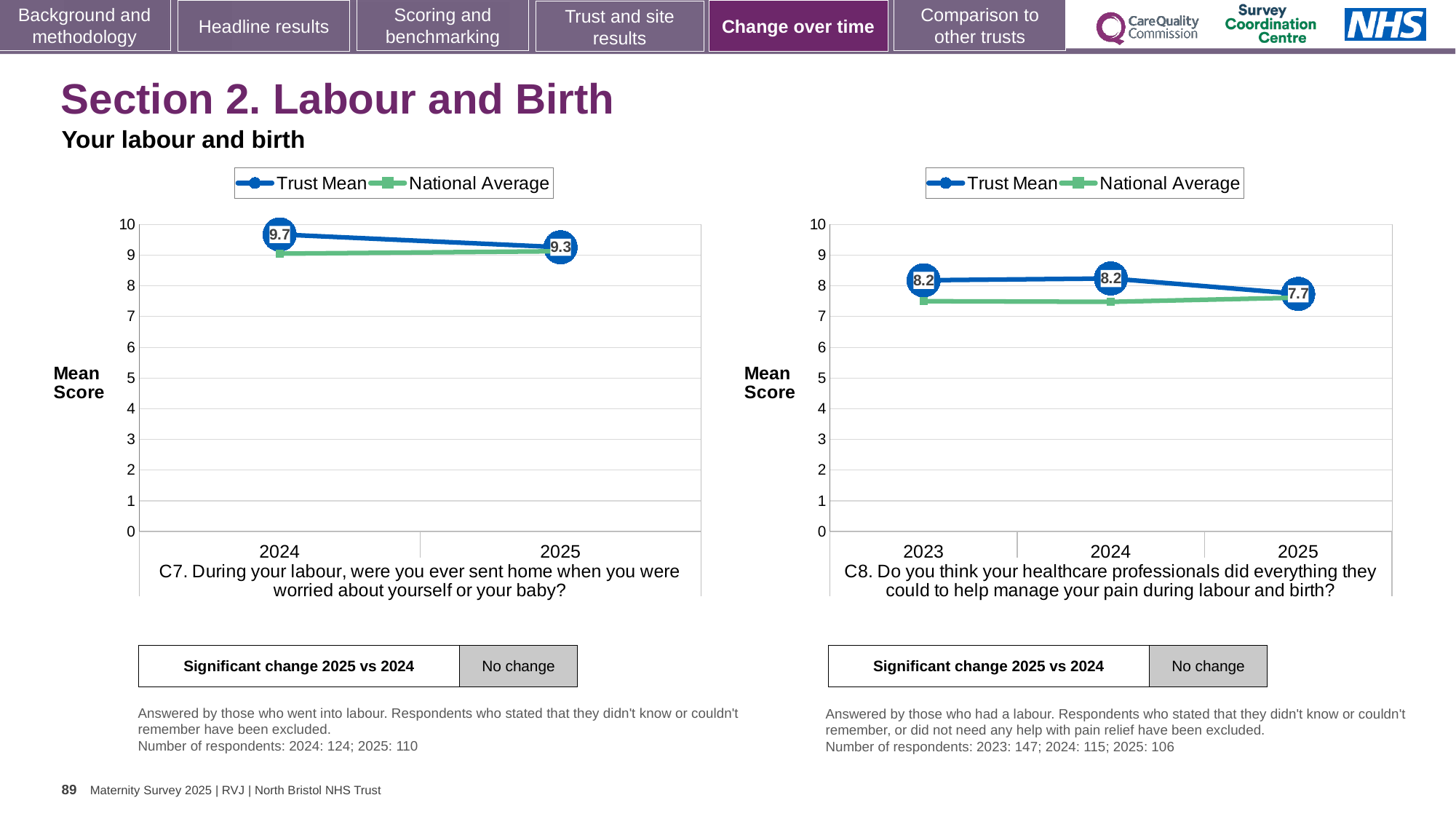
In the C7 chart on the left, by how much did the Trust Mean fall from 2024 to 2025? 0.4 In the C8 chart on the right, how many years are shown on the x axis? 3 In the C8 chart on the right, is the Trust Mean for 2023 larger or smaller than the Trust Mean for 2025? larger How many series does the legend of the C7 chart on the left list? 2 In the C7 chart on the left, is the National Average for 2024 greater or less than 8? greater In the C8 chart on the right, what is the Trust Mean for 2023? 8.2 In the C8 chart on the right, what is the Trust Mean for 2025? 7.7 In the C7 chart on the left, what is the Trust Mean for 2025? 9.3 What kind of chart is the C8 chart on the right? line chart In the C8 chart on the right, what is the difference between the Trust Mean in 2024 and in 2025? 0.5 In the C7 chart on the left, what is the Trust Mean for 2024? 9.7 In the C7 chart on the left, does the Trust Mean rise or fall from 2024 to 2025? fall